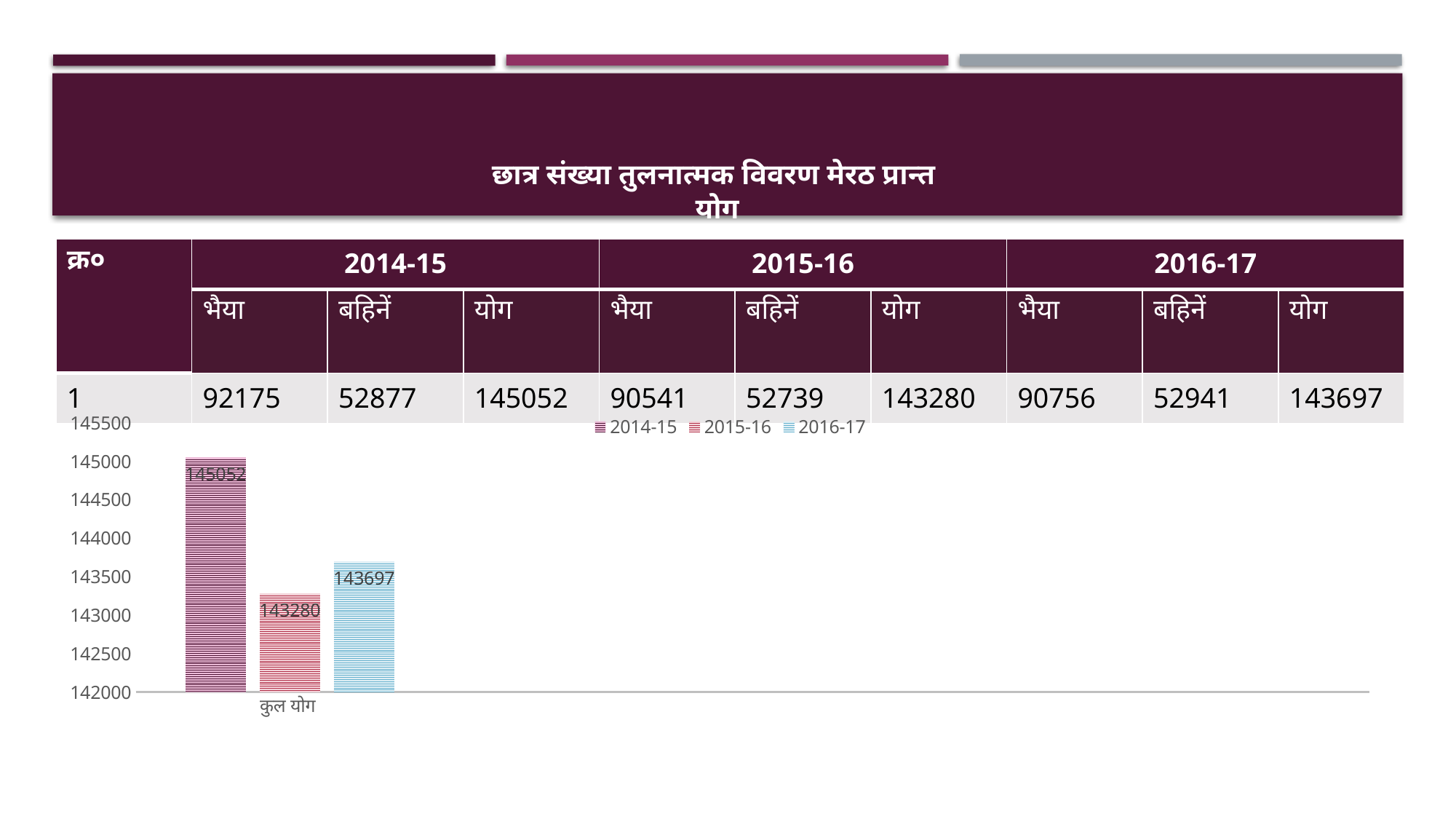
Which series has the highest value in the chart? 2014-15 What kind of chart is shown on the slide? bar chart Is the value for 2014-15 in the chart greater or less than 144000? greater Which series has the lowest value in the chart? 2015-16 What is the value for the 2016-17 series in the chart? 143697 Which is larger in the chart, the 2016-17 value or the 2015-16 value? 2016-17 What is the value for the 2015-16 series in the chart? 143280 What is the difference between the 2016-17 value and the 2015-16 value in the chart? 417 What is the value for the 2014-15 series in the chart? 145052 How many series does the chart legend list? 3 What is the difference between the 2014-15 value and the 2015-16 value in the chart? 1772 How many categories are shown on the x axis of the chart? 1